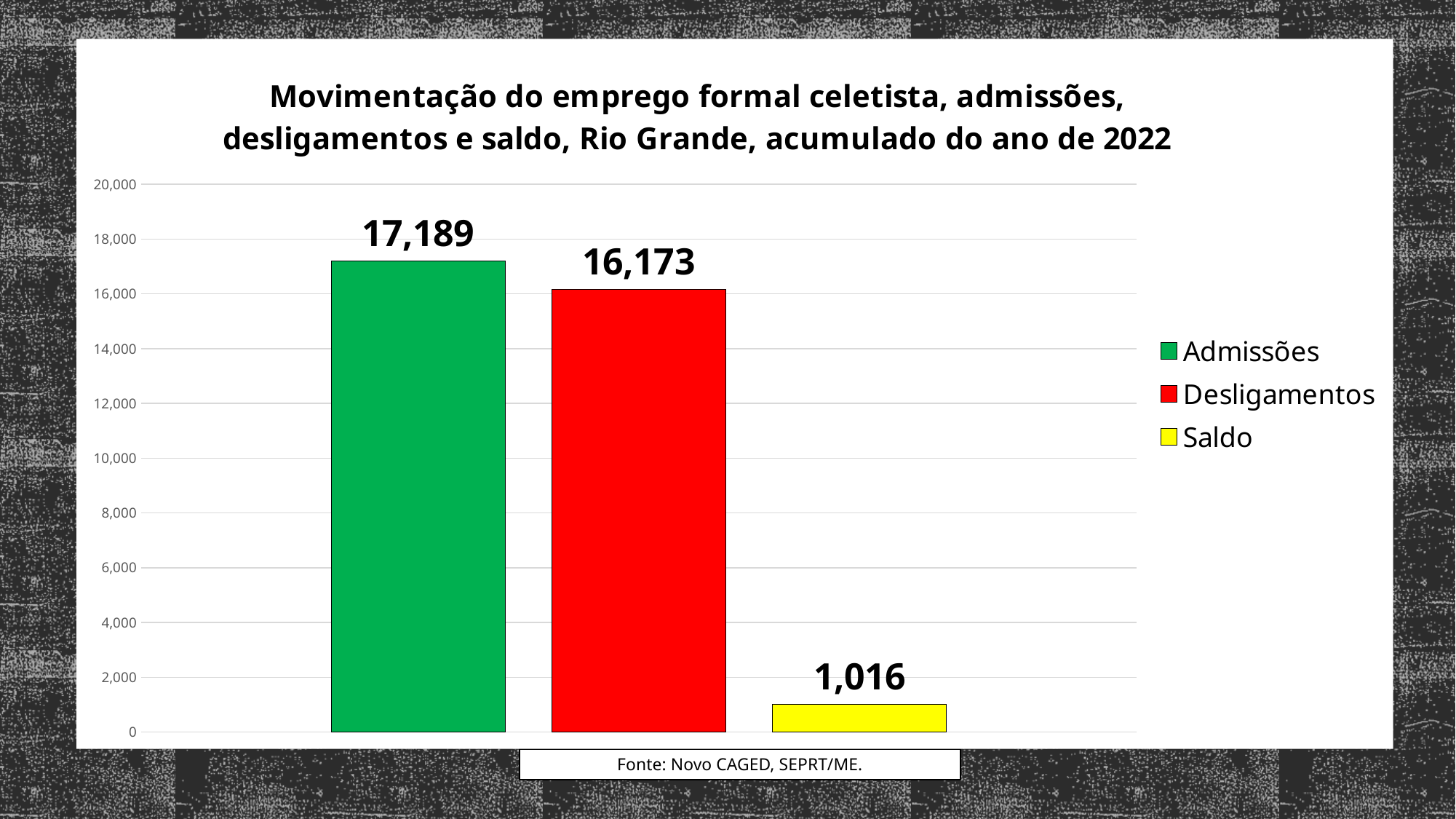
What is the value for Admissões? 17,189 What is the value for Desligamentos? 16,173 What is the value for Saldo? 1,016 Which is larger, Admissões or Desligamentos? Admissões How many bars are plotted in the chart? 3 What kind of chart is shown? bar chart How many series does the legend list? 3 Which series has the lowest value? Saldo What colour is the bar for Saldo? yellow Is the value for Saldo greater or less than 2,000? less What is the difference between Admissões and Desligamentos? 1,016 Which series has the highest value? Admissões